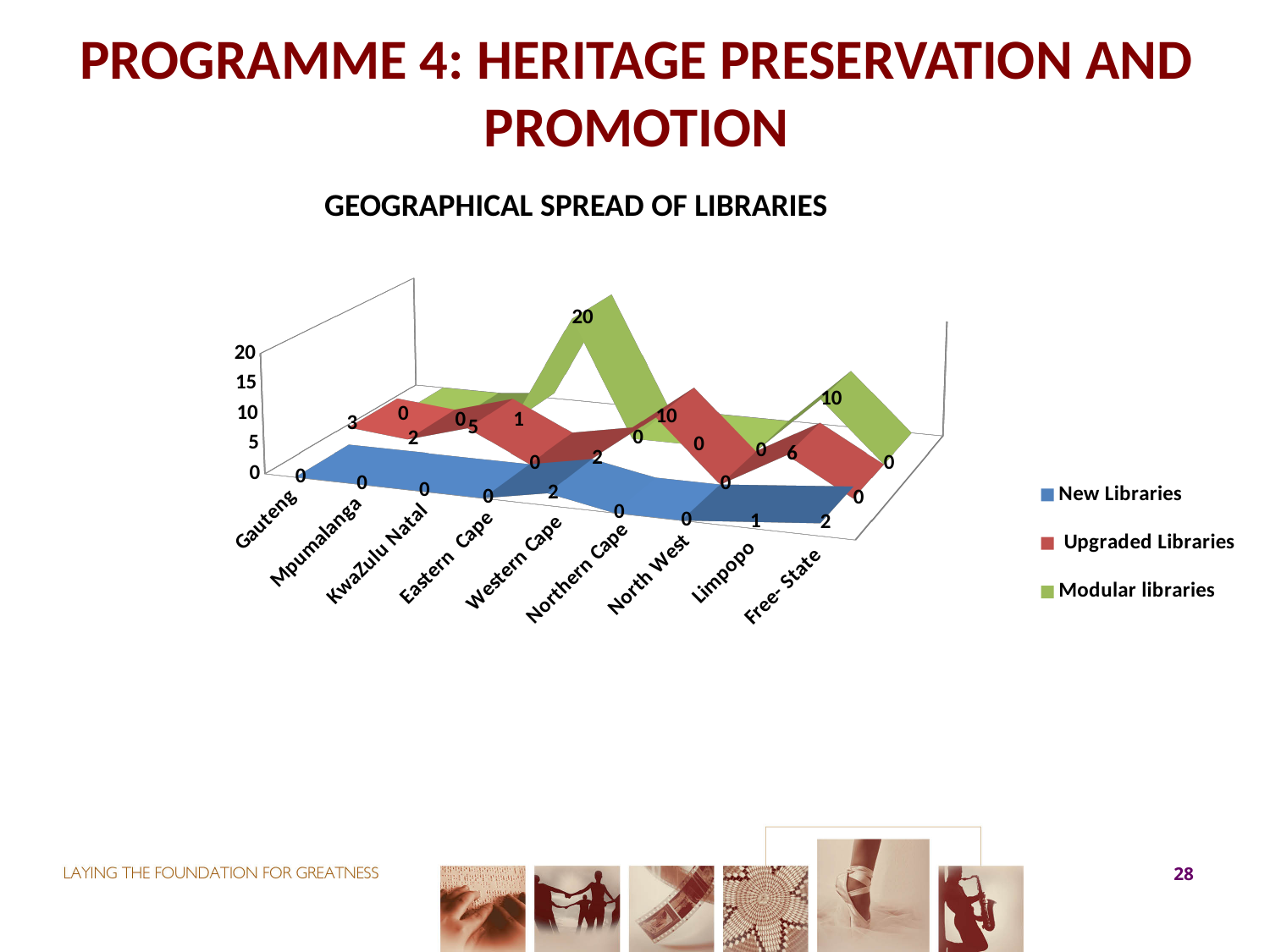
What is the title of the chart? GEOGRAPHICAL SPREAD OF LIBRARIES Which series are listed in the legend? New Libraries, Upgraded Libraries, Modular libraries Is the peak value of the Modular libraries series greater or less than 15? greater What is the value for New Libraries in Gauteng? 0 What is the value for Upgraded Libraries in Gauteng? 3 Which series reaches the highest value on the chart? Modular libraries How many provinces are shown on the x axis? 9 What is the value for New Libraries in Limpopo? 1 What kind of chart is shown on the slide? line chart What is the value for New Libraries in Free- State? 2 What is the highest value plotted on the chart? 20 How many series does the legend list? 3